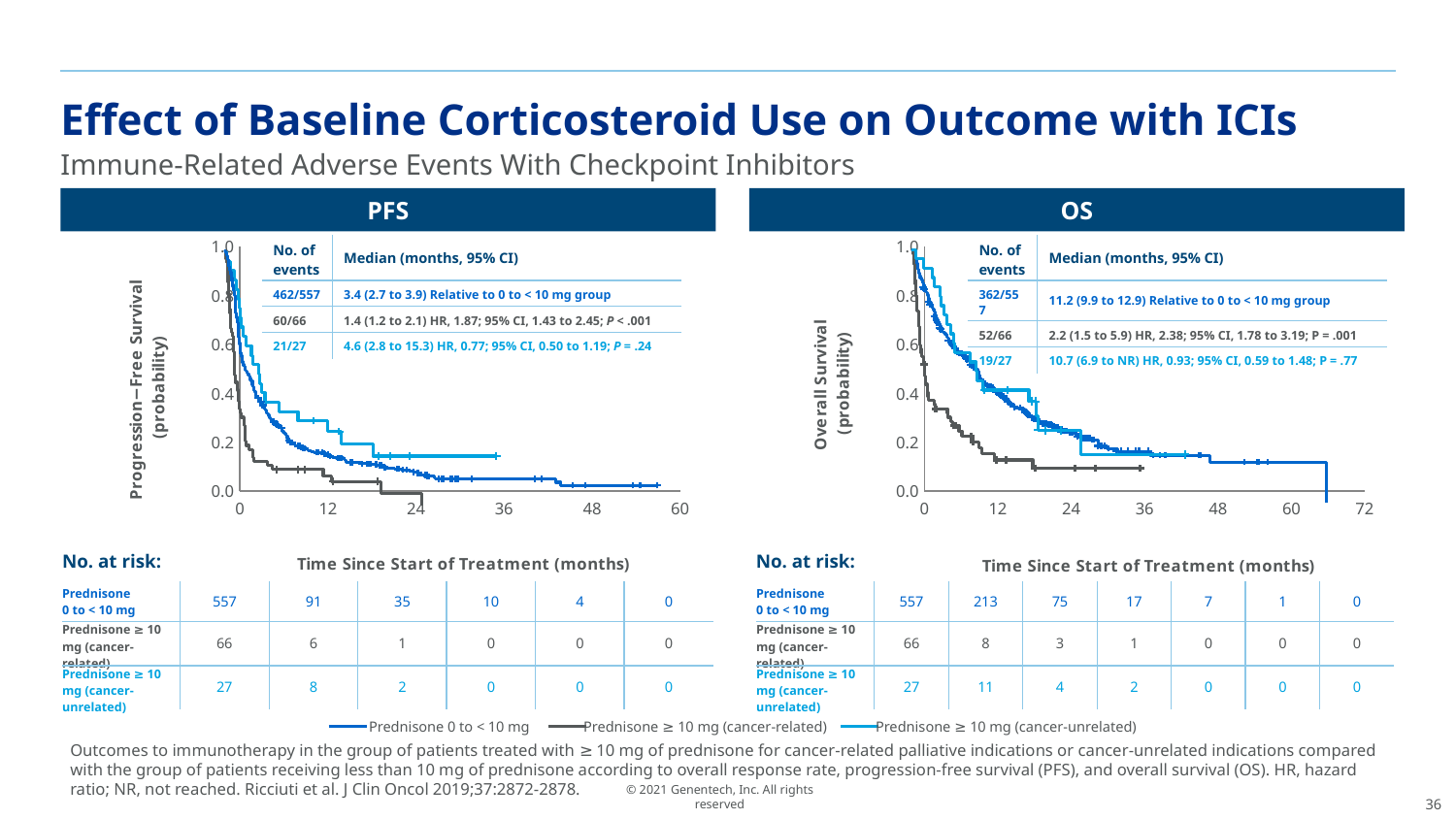
In the PFS chart, how many events out of how many patients are listed for the Prednisone ≥ 10 mg (cancer-unrelated) group? 21/27 How many series does the legend at the bottom of the slide list? 3 In the OS chart, what is the median OS in months for the Prednisone ≥ 10 mg (cancer-related) group? 2.2 In the OS chart, do the survival curves rise or fall as time since start of treatment increases? Fall In the PFS chart, which group has the lowest median PFS in months? Prednisone ≥ 10 mg (cancer-related) (1.4) In the PFS chart, what is the difference in median PFS (months) between the Prednisone 0 to < 10 mg group (3.4) and the Prednisone ≥ 10 mg (cancer-related) group (1.4)? 2.0 What kind of chart is the PFS chart? Line chart (Kaplan-Meier survival curve) In the OS chart, how many events out of how many patients are listed for the Prednisone 0 to < 10 mg group? 362/557 In the PFS chart, what is the median PFS in months for the Prednisone 0 to < 10 mg group? 3.4 In the PFS No. at risk table, how many patients in the Prednisone ≥ 10 mg (cancer-unrelated) group are at risk at 12 months? 8 In the OS No. at risk table, how many patients in the Prednisone 0 to < 10 mg group are at risk at 12 months? 213 In the OS chart, which group has the highest median OS in months? Prednisone 0 to < 10 mg (11.2)